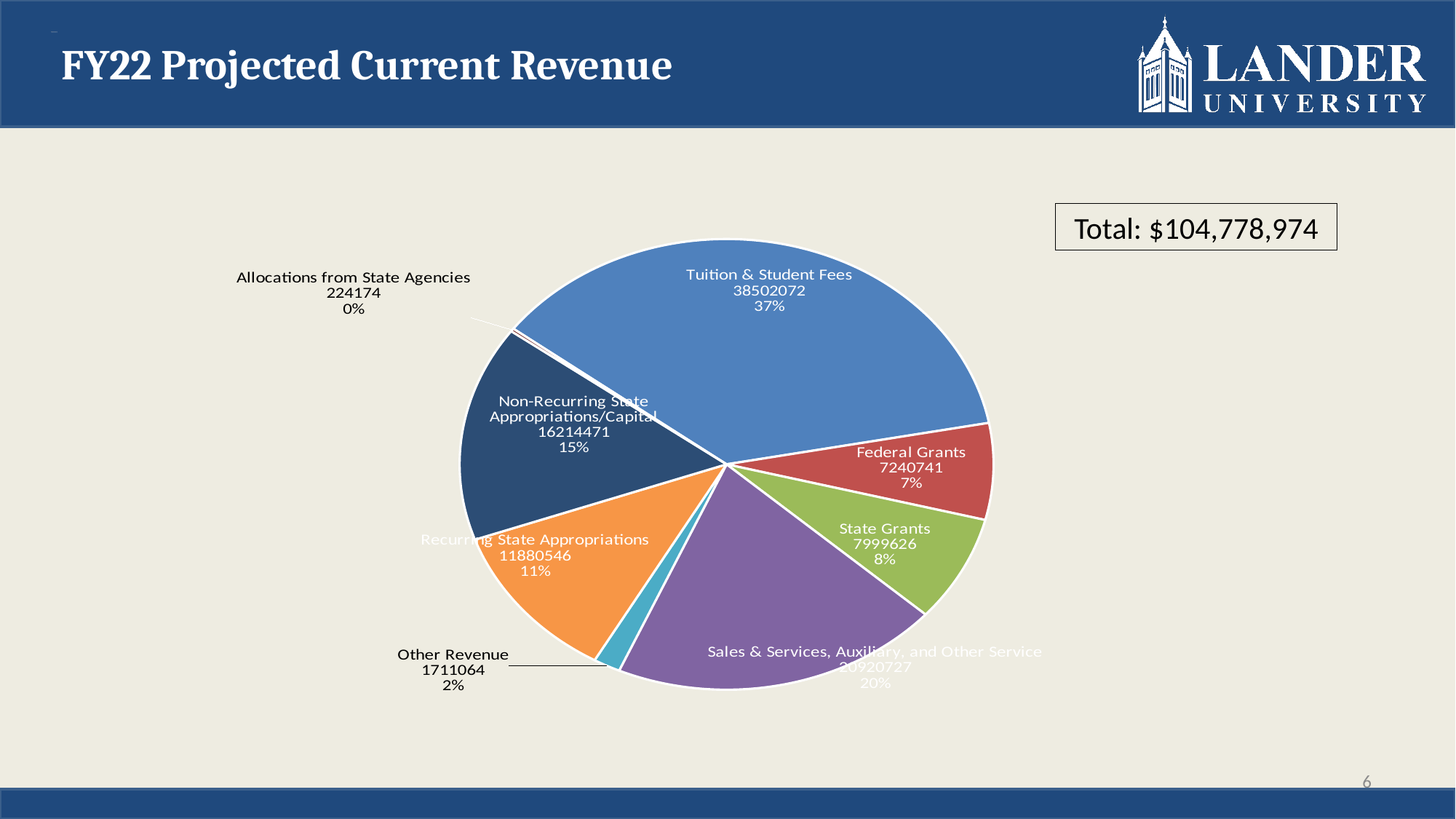
What kind of chart is shown on the slide? Pie chart What share of the pie does Non-Recurring State Appropriations/Capital represent? 15% Which category has the smallest slice of the pie? Allocations from State Agencies What is the value for Tuition & Student Fees? 38502072 What is the value for Recurring State Appropriations? 11880546 What is the value for Federal Grants? 7240741 What share of the pie does Sales & Services, Auxiliary, and Other Service represent? 20% Which category has the largest slice of the pie? Tuition & Student Fees Which is larger, Non-Recurring State Appropriations/Capital or Recurring State Appropriations? Non-Recurring State Appropriations/Capital How many categories are shown in the pie chart? 8 What total is shown in the box next to the chart? $104,778,974 What is the difference between the values for State Grants and Federal Grants? 758885